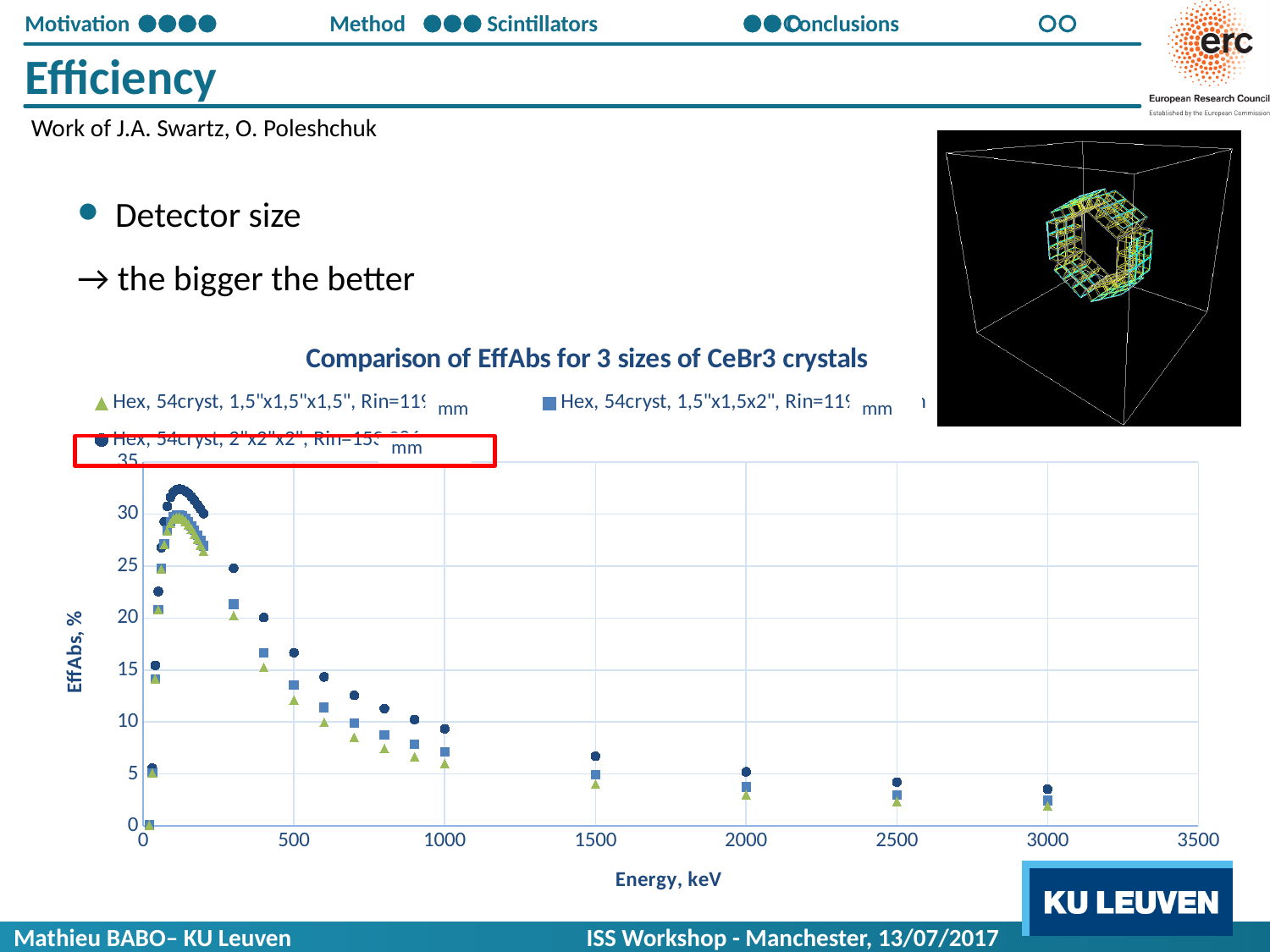
How many series does the chart legend list? 3 Is the peak EffAbs value of the 2"x2"x2" series greater or less than 30? greater Is the EffAbs value of the 1,5"x1,5"x1,5" series at 1500 keV greater or less than 5? less What is the label of the x axis of the chart? Energy, keV Is the EffAbs value of the 2"x2"x2" series at 3000 keV greater or less than 5? less Which series has the lowest EffAbs values across the energy range? Hex, 54cryst, 1,5"x1,5"x1,5" Which series reaches the highest EffAbs values in the chart? Hex, 54cryst, 2"x2"x2" At 500 keV, which series has the larger EffAbs value: 2"x2"x2" or 1,5"x1,5"x1,5"? 2"x2"x2" What kind of chart is shown on the slide? scatter chart Do the EffAbs values rise or fall as energy increases from 500 keV to 3000 keV? fall What is the title of the chart? Comparison of EffAbs for 3 sizes of CeBr3 crystals